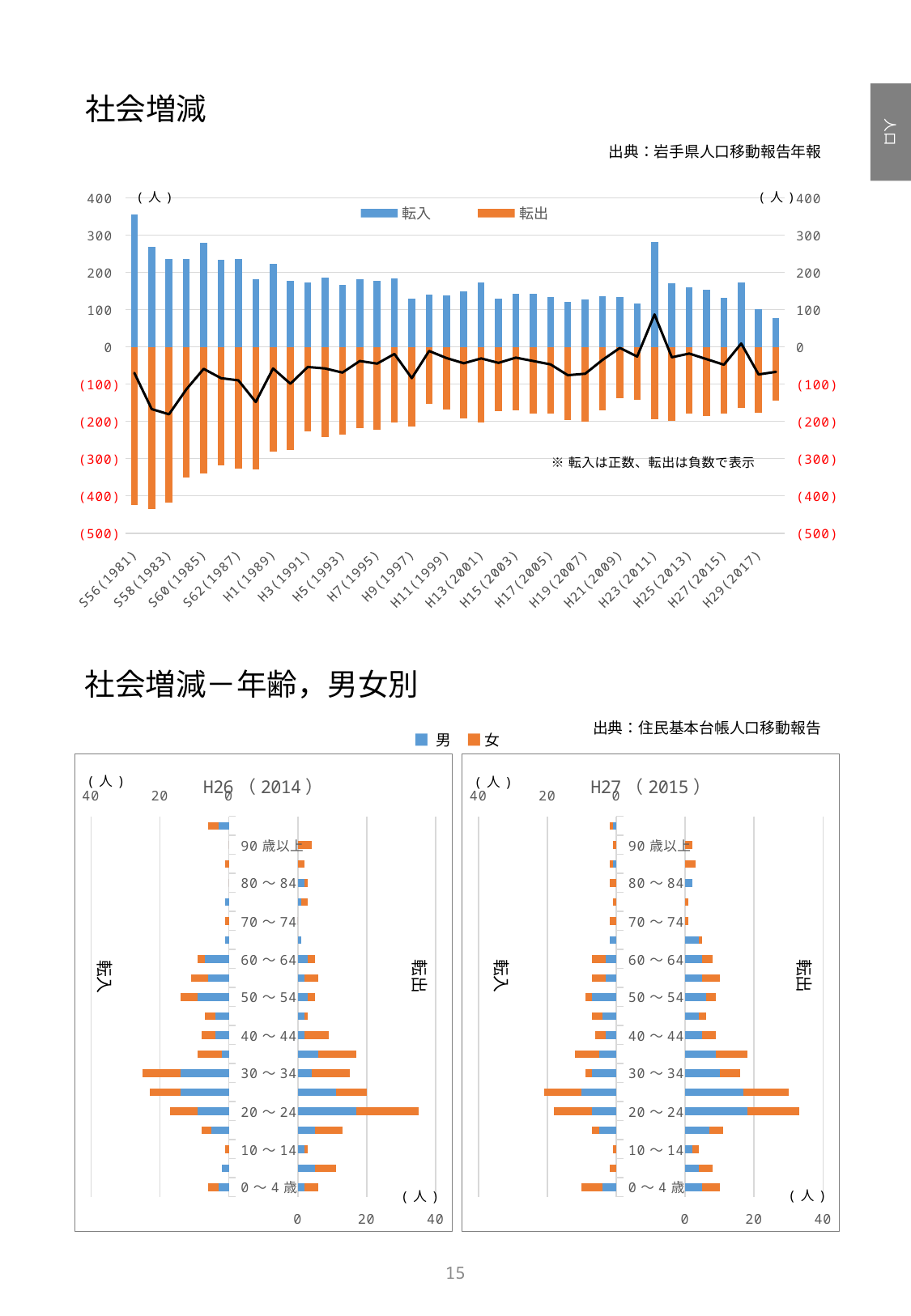
In the top chart titled 社会増減, does the 転入 value generally rise or fall from S56(1981) to H29(2017)? fall In the top chart titled 社会増減, which is larger, the 転入 value for S56(1981) or for H29(2017)? S56(1981) In the bottom-left chart titled H26 (2014), which age group has the longest 転出 bar? 20～24 In the bottom-left chart titled H26 (2014), is the 転出 value for 20～24 greater or less than 20? greater In the top chart titled 社会増減, is the 転入 value for H23(2011) greater or less than 200? greater In the top chart titled 社会増減, how many series does the legend list? 2 In the top chart titled 社会増減, which colour represents 転出? orange In the bottom charts titled 社会増減－年齢，男女別, how many series does the legend list? 2 In the top chart titled 社会増減, which year has the highest 転入 value? S56(1981) In the top chart titled 社会増減, is the 転入 value for S56(1981) greater or less than 300? greater In the top chart titled 社会増減, what kind of chart is used to show 転入 and 転出? bar chart